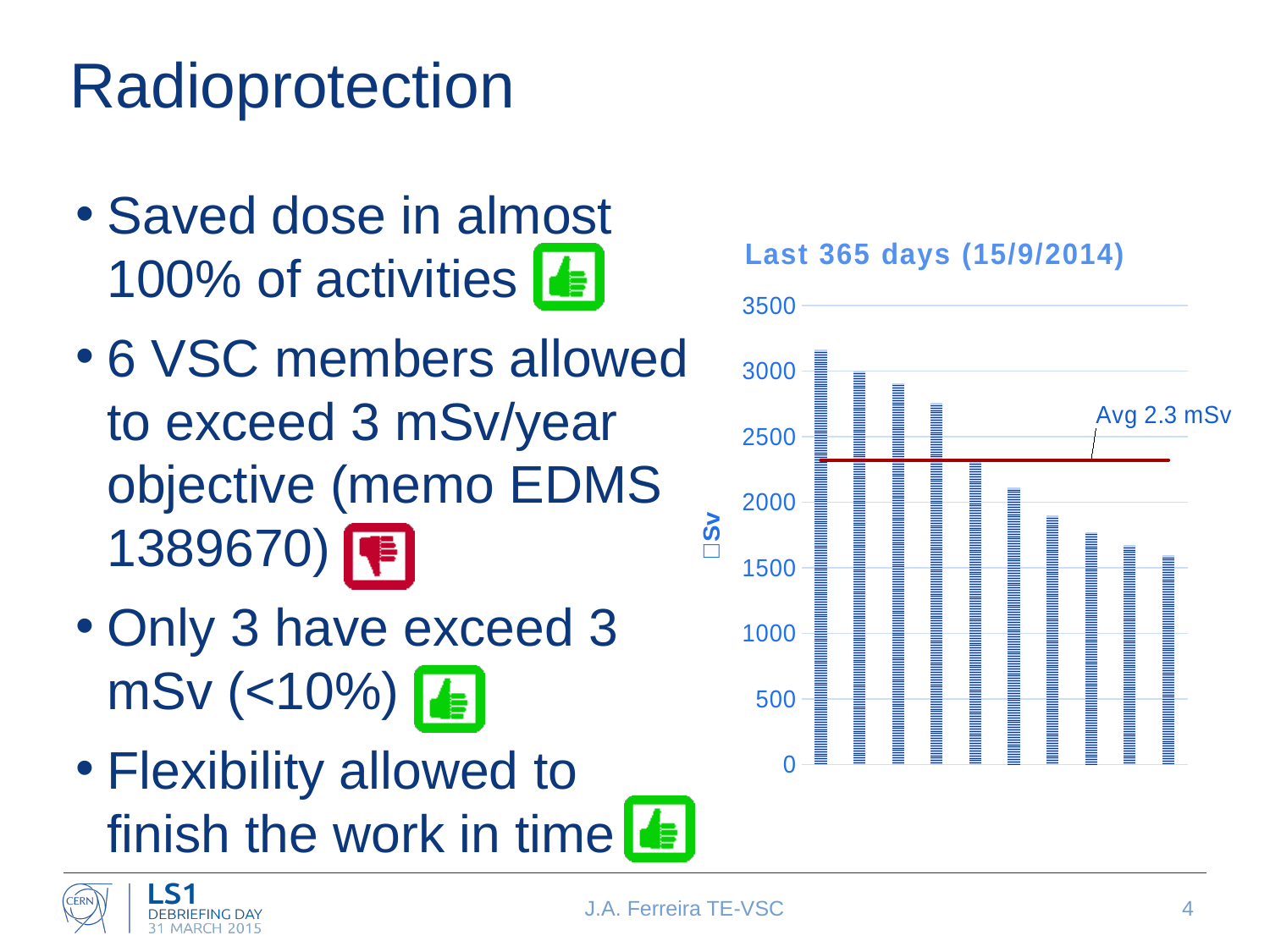
Is the value of the sixth bar from the left greater or less than 2500? less Is the value of the last (rightmost) bar greater or less than 2000? less Which bar is the lowest in the chart? The rightmost (last) bar Is the value of the fourth bar from the left greater or less than 2500? greater Do the bar values rise or fall from left to right across the chart? Fall What kind of chart is shown on the slide? Bar chart Which bar is the highest in the chart? The leftmost (first) bar What average value is annotated by the red horizontal line on the chart? Avg 2.3 mSv How many bars are plotted in the chart? 10 Which is larger, the value of the second bar or the value of the ninth bar? The second bar What is the title of the chart? Last 365 days (15/9/2014)